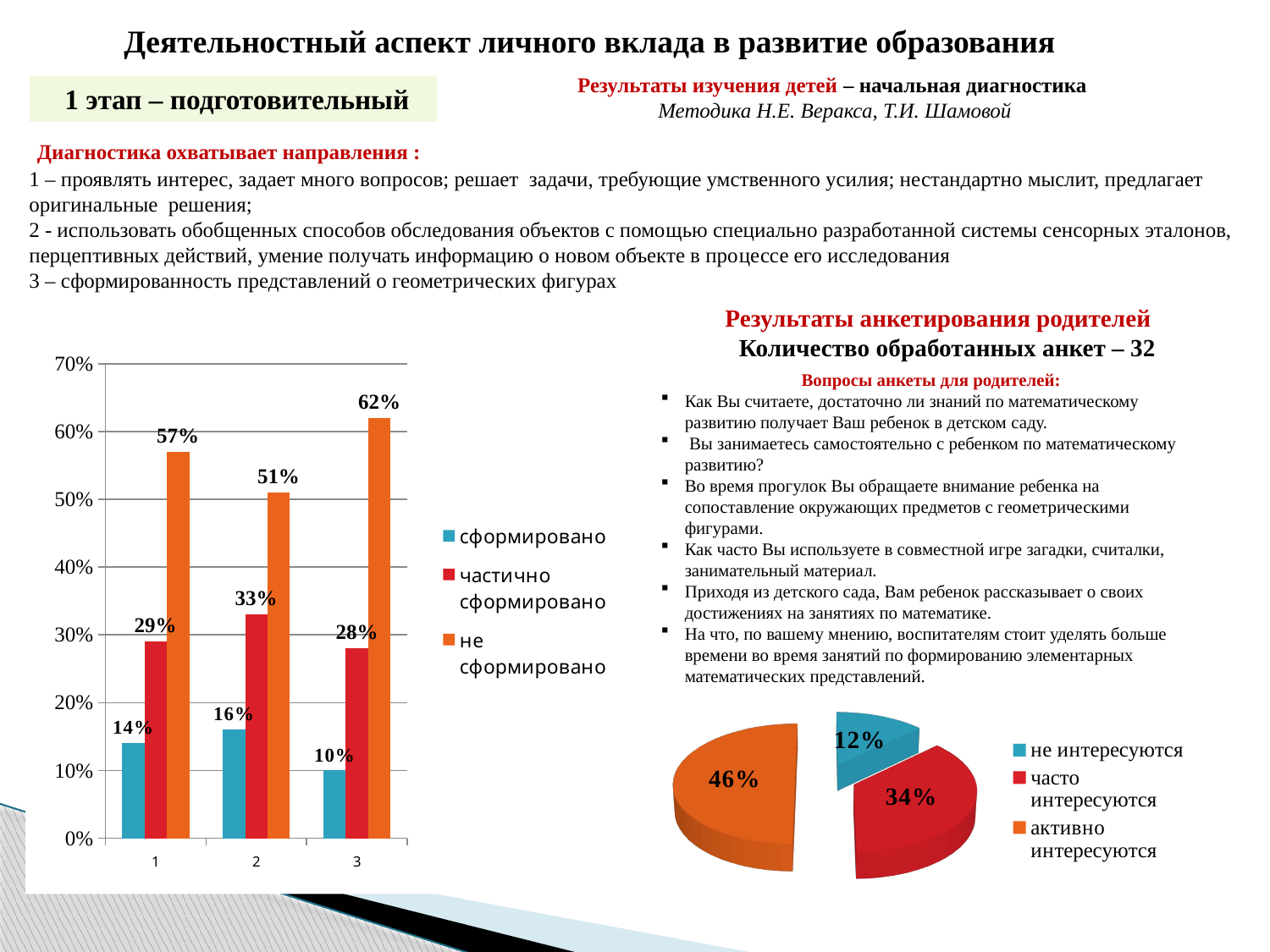
How many series does the legend of the bar chart on the left list? 3 What kind of chart is the chart at the bottom right of the slide? pie chart In the bar chart on the left, what is the value of "частично сформировано" for category 2? 33% In the bar chart on the left, what is the value of "сформировано" for category 1? 14% In the bar chart on the left, what is the value of "не сформировано" for category 3? 62% In the bar chart on the left, which is larger for category 2: "сформировано" or "частично сформировано"? частично сформировано In the bar chart on the left, which category has the highest value for "не сформировано"? 3 In the pie chart at the bottom right, which slice is the largest? активно интересуются In the bar chart on the left, which category has the lowest value for "сформировано"? 3 How many categories are shown on the x axis of the bar chart on the left? 3 In the pie chart at the bottom right, what share is labelled for "часто интересуются"? 34% In the bar chart on the left, what is the difference between "не сформировано" and "сформировано" for category 1? 43%